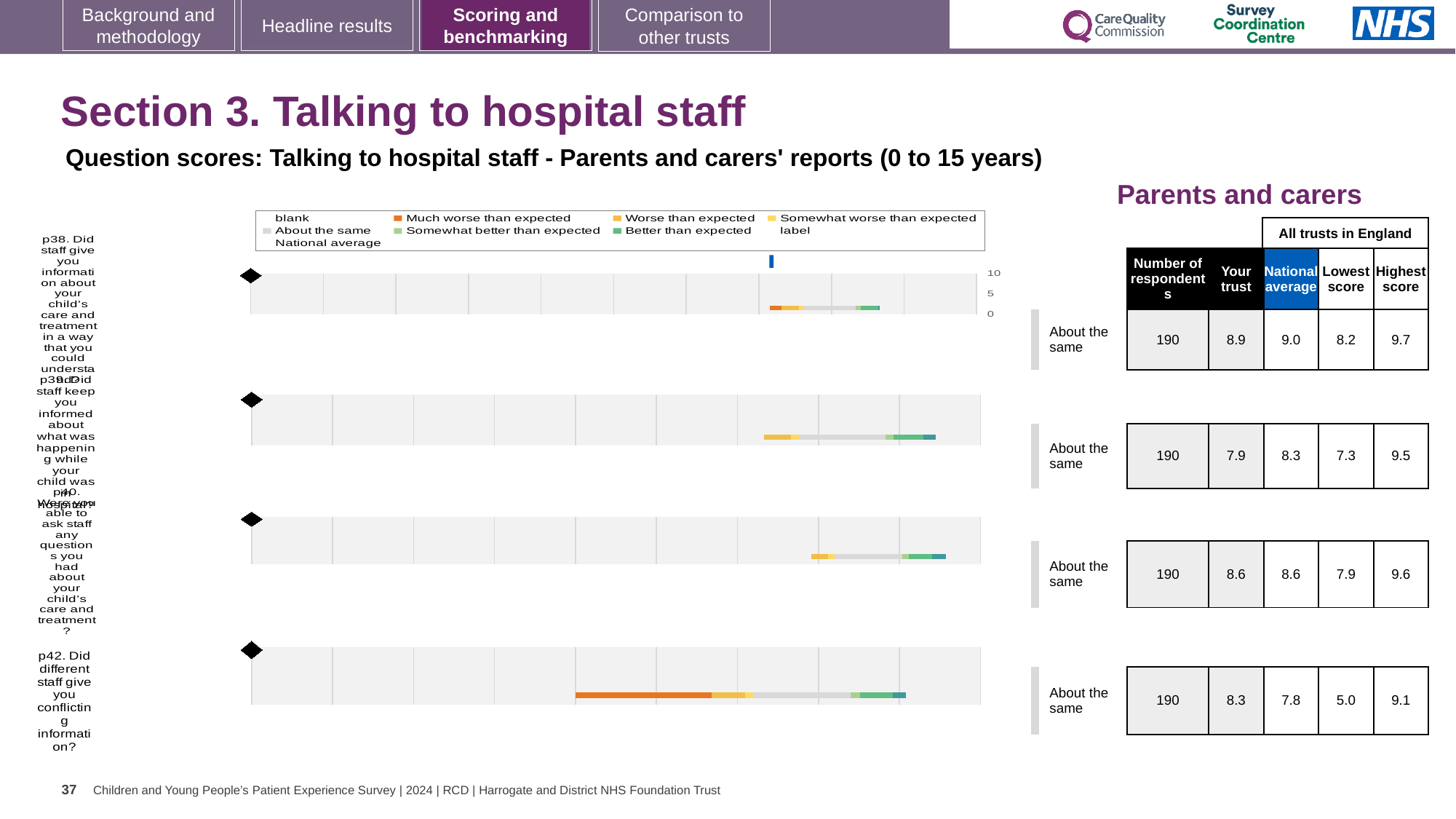
In the table beside the p42 chart, what is the National average score? 7.8 How many respondents are listed for p40 in the table? 190 For p39, which is larger: the 'Your trust' score or the National average? National average Which question has the lowest 'Lowest score' value in the tables? p42 What colour represents 'Much worse than expected' in the chart legend? orange What is the highest tick value shown on the score axis of the p38 chart? 10 What kind of chart is used to show the question scores on this slide? bar chart How many question charts (p38, p39, p40, p42) are shown on the slide? 4 In the table beside the p38 chart, what is the 'Your trust' score? 8.9 Which question has the highest 'Your trust' score in the tables? p38 How many entries does the chart legend list? 9 For p42, what is the difference between the Highest score and the Lowest score in the table? 4.1